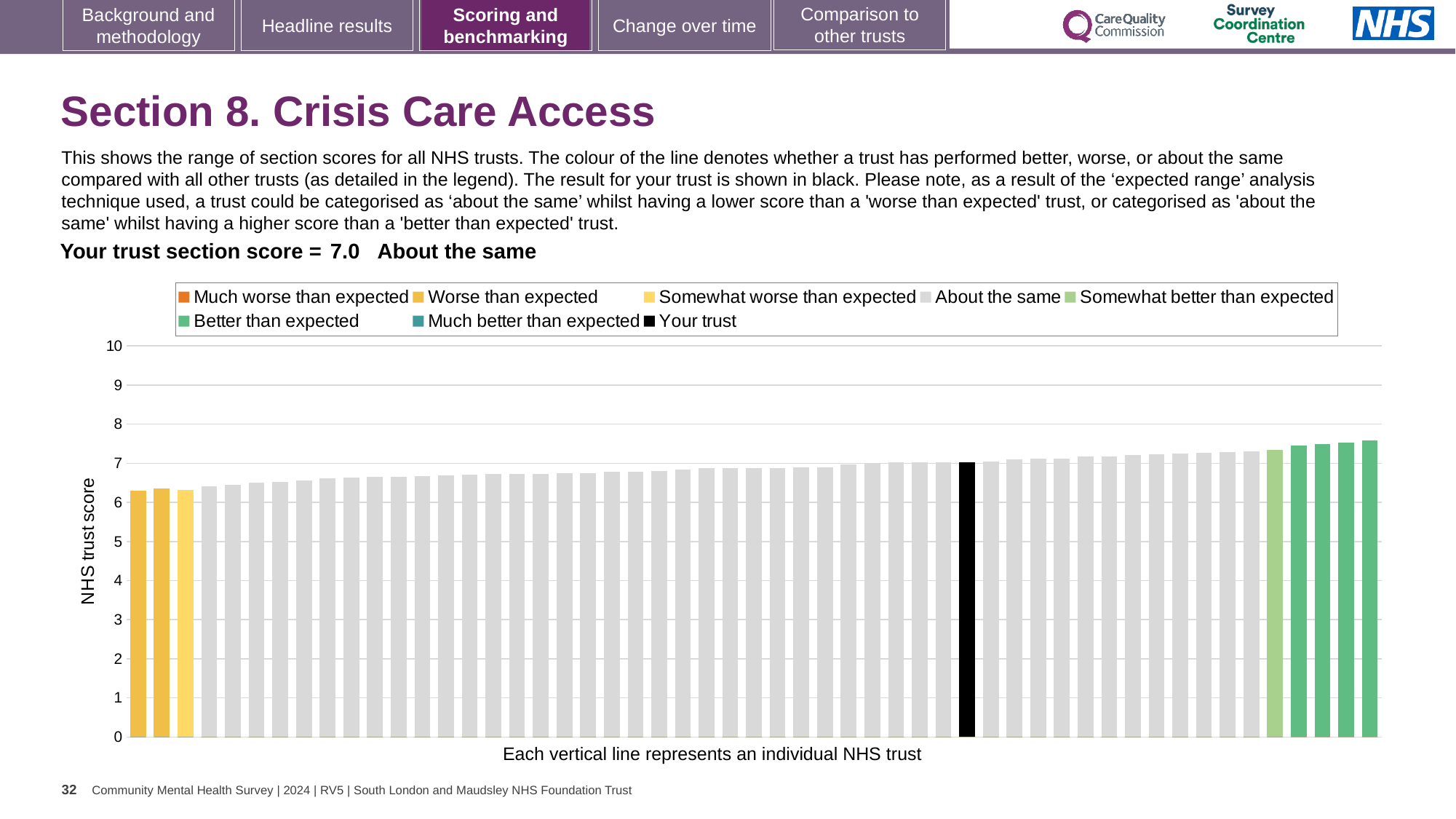
Is the value of the leftmost bar greater or less than 6? greater How many entries does the chart legend list? 8 What kind of chart is shown on the slide? bar chart How many bars are coloured as 'Better than expected'? 4 Do the bar values rise or fall from left to right along the x axis? rise Is the value of the leftmost bar greater or less than 7? less What is the section score for your trust shown on the slide? 7.0 Which performance category is your trust placed in for Crisis Care Access? About the same What is the label on the vertical axis of the chart? NHS trust score Which is larger, the value of the black bar for your trust or the value of the rightmost bar? the rightmost bar Which legend category do the tallest bars on the right of the chart belong to? Better than expected Is the value of the tallest bar greater or less than 7? greater